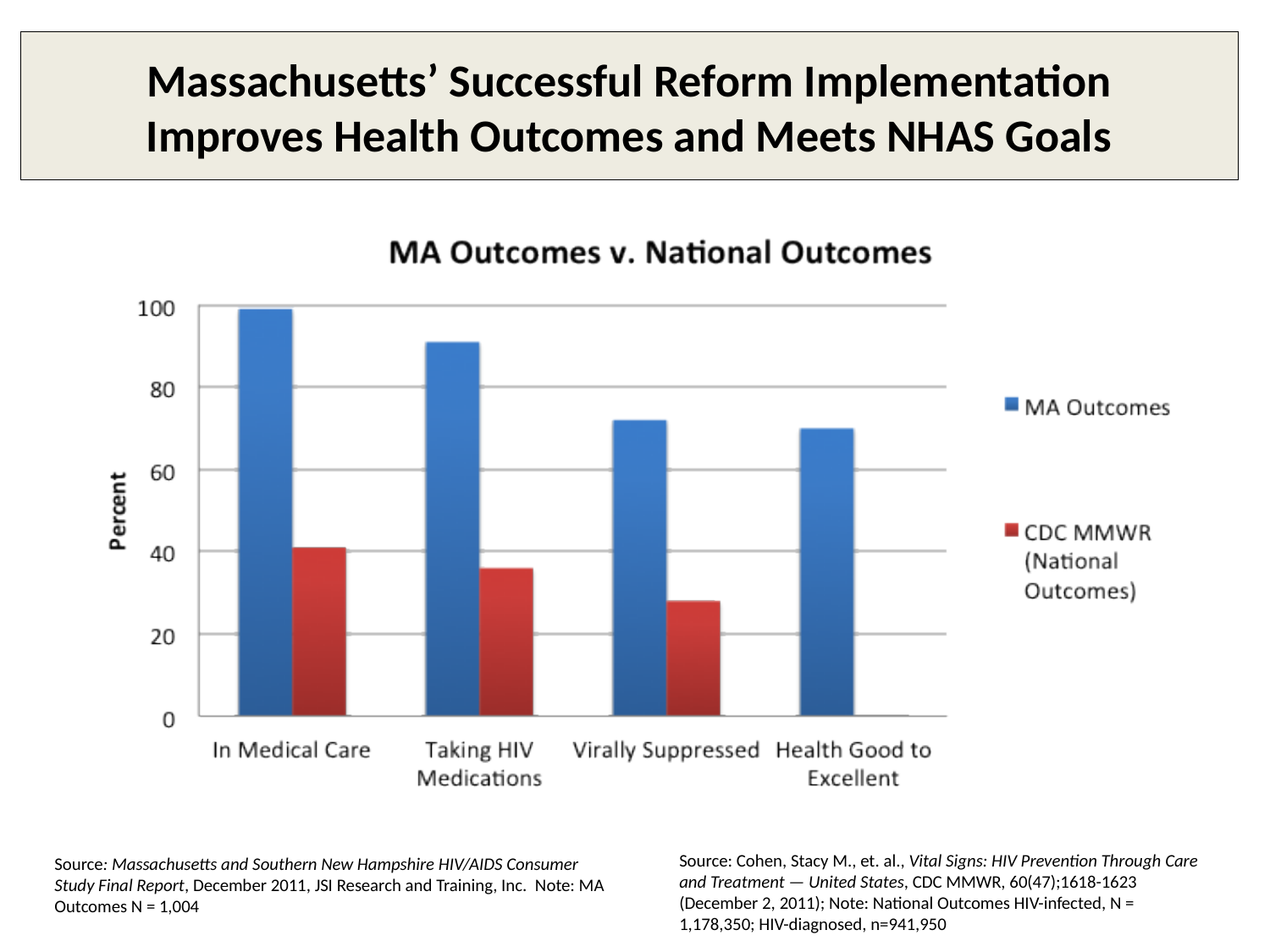
How many series does the chart's legend list? 2 What kind of chart is shown on the slide? Bar chart What is the label on the chart's vertical axis? Percent Is the CDC MMWR (National Outcomes) value for Virally Suppressed greater or less than 20? greater Is the CDC MMWR (National Outcomes) value for Taking HIV Medications greater or less than 40? less Which category has the highest MA Outcomes value? In Medical Care What is the title of the chart? MA Outcomes v. National Outcomes Is the MA Outcomes value for Virally Suppressed greater or less than 80? less Do the MA Outcomes values rise or fall moving left to right across the categories? fall How many categories are shown on the x axis of the chart? 4 For In Medical Care, which series has the larger value: MA Outcomes or CDC MMWR (National Outcomes)? MA Outcomes